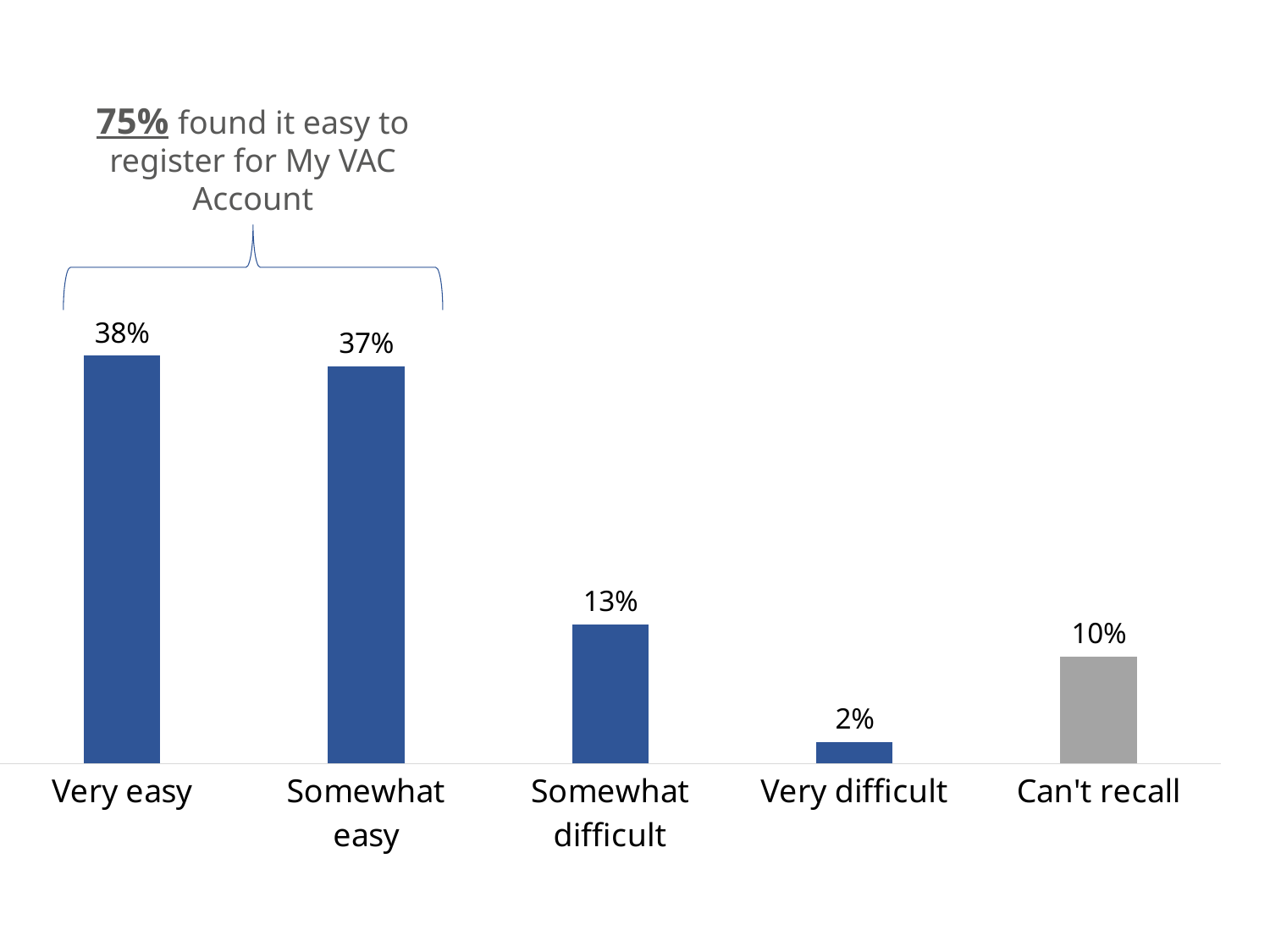
Which category has the lowest value? Very difficult What is the value for Somewhat easy? 37% What is the value for Somewhat difficult? 13% According to the annotation above the chart, what percentage found it easy to register for My VAC Account? 75% What is the value for Can't recall? 10% What percentage of respondents found it very easy to register? 38% What is the value for Very difficult? 2% What kind of chart is shown on the slide? Bar chart How many categories are shown on the chart? 5 What is the difference between Somewhat difficult and Can't recall? 3% Which category has the highest value? Very easy Which is larger, Somewhat difficult or Can't recall? Somewhat difficult